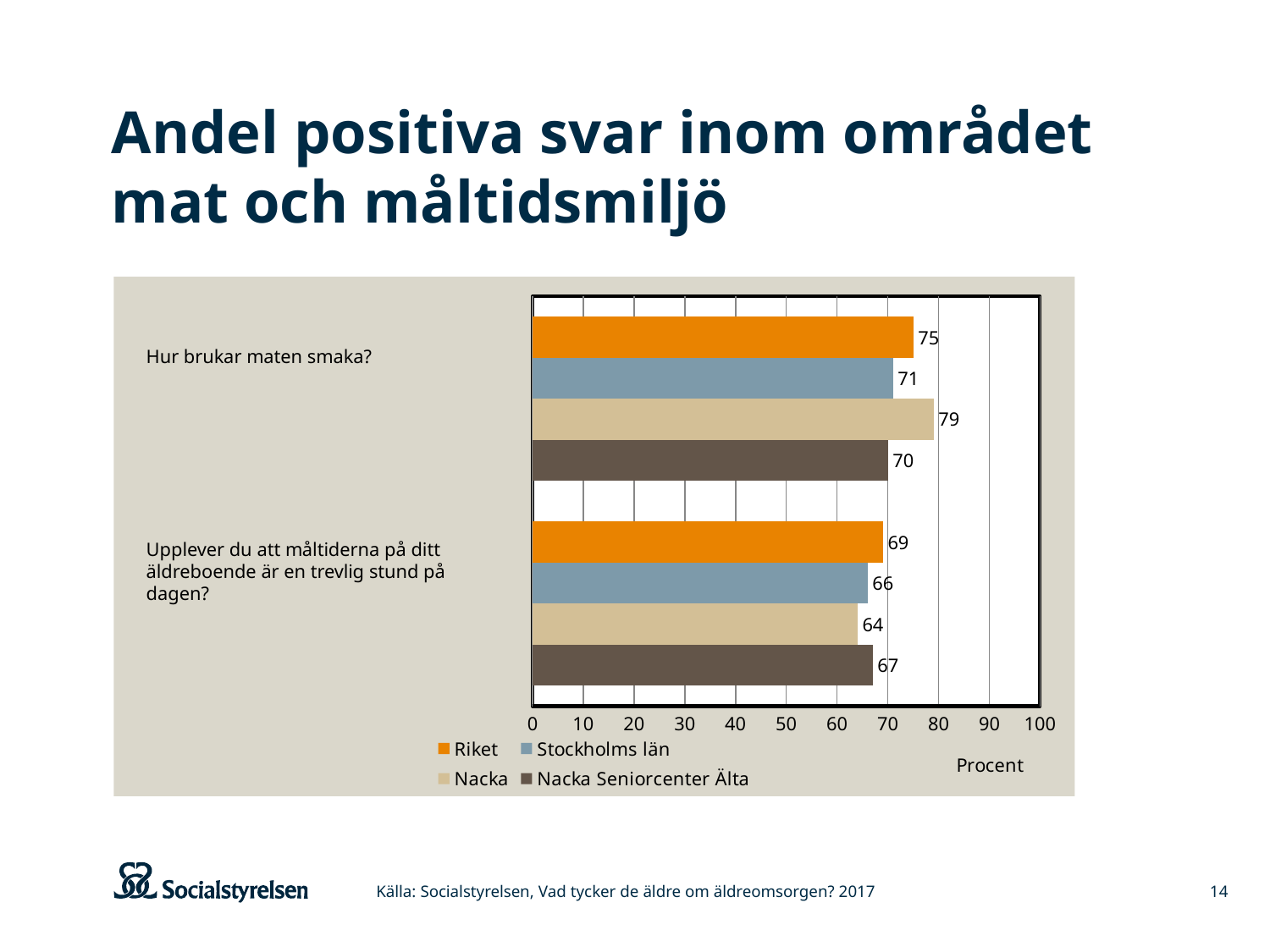
What is the value for Nacka Seniorcenter Älta for the question "Hur brukar maten smaka?"? 70 What is the value for Riket for the question "Upplever du att måltiderna på ditt äldreboende är en trevlig stund på dagen?"? 69 What is the difference between the Nacka value and the Stockholms län value for "Hur brukar maten smaka?"? 8 What is the value for Nacka for the question "Hur brukar maten smaka?"? 79 For "Upplever du att måltiderna på ditt äldreboende är en trevlig stund på dagen?", which is larger: the value for Stockholms län or the value for Nacka Seniorcenter Älta? Nacka Seniorcenter Älta How many series does the legend list? 4 Which series has the highest value for the question "Hur brukar maten smaka?"? Nacka What kind of chart is shown on the slide? Bar chart Is the value for Riket for "Hur brukar maten smaka?" greater or less than 70? greater What is the label of the horizontal axis? Procent How many questions (categories) are shown on the chart? 2 Which series has the lowest value for the question "Upplever du att måltiderna på ditt äldreboende är en trevlig stund på dagen?"? Nacka